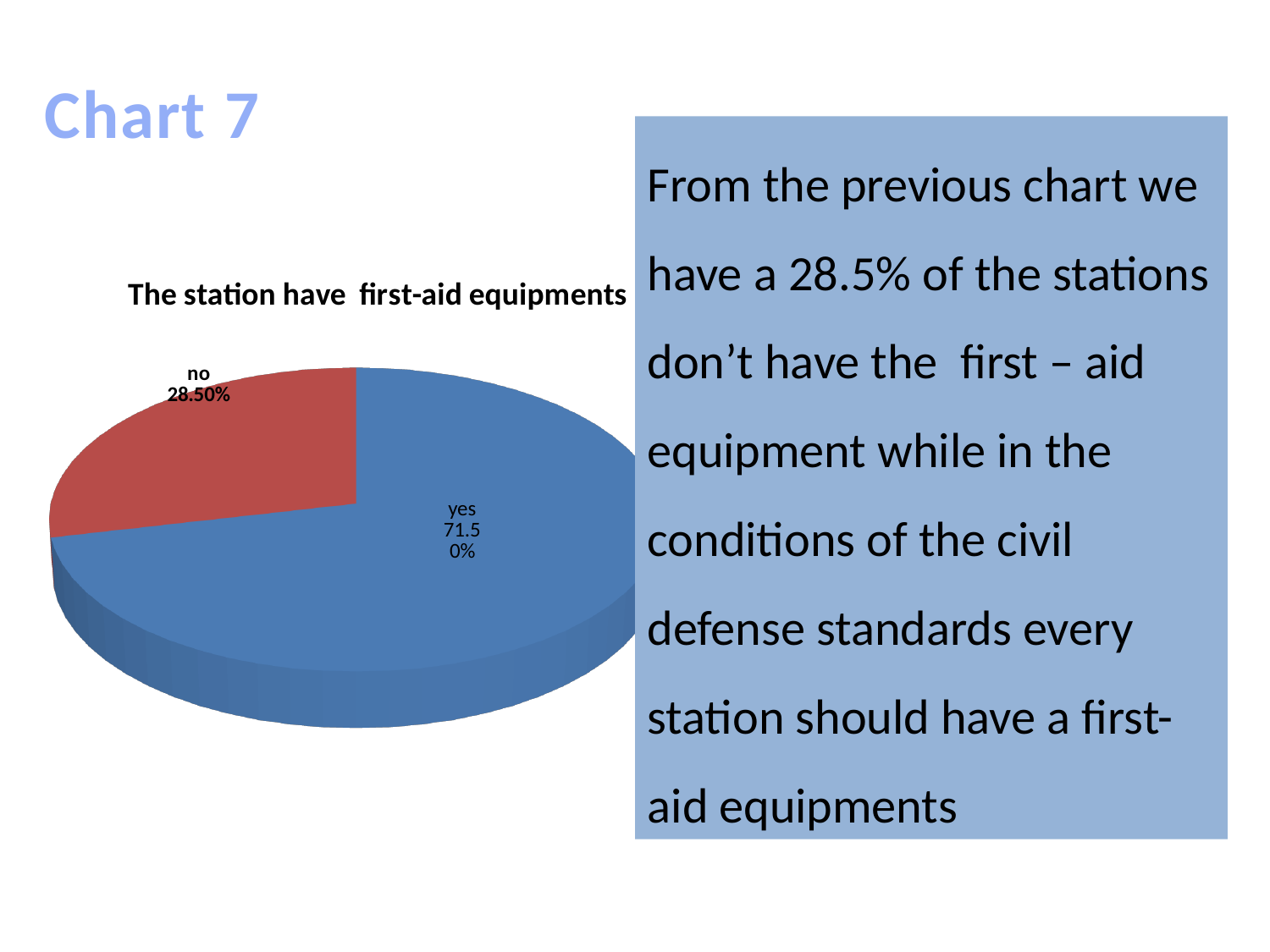
What percentage of the pie is labelled "yes"? 71.50% How many slices does the pie chart have? 2 What is the title of the chart? The station have first-aid equipments Which slice is larger, "yes" or "no"? yes What kind of chart is shown on the slide? pie chart What colour is the "no" slice of the pie? red What is the difference in percentage points between the "yes" and "no" slices? 43 percentage points Which slice of the pie is the largest? yes What share of the pie does the "no" slice represent? 28.50% Which slice of the pie is the smallest? no What percentage of the pie is labelled "no"? 28.50%